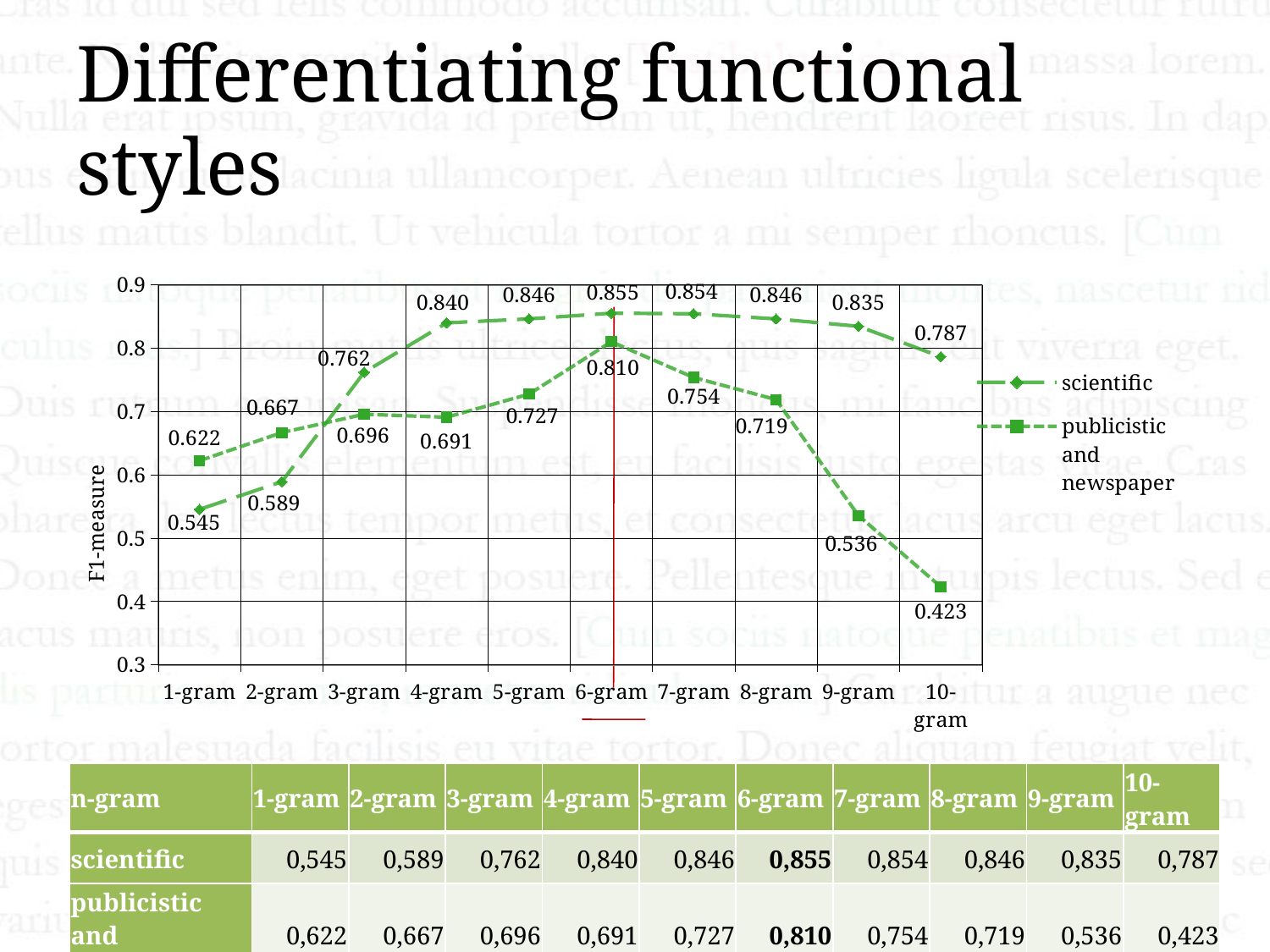
Is the F1-measure for the publicistic and newspaper series at 9-gram greater or less than 0.6? less Does the publicistic and newspaper series rise or fall from 6-gram to 10-gram? fall How many series does the chart legend list? 2 What is the F1-measure for the publicistic and newspaper series at 1-gram? 0.622 At which n-gram does the scientific series have its lowest F1-measure? 1-gram What is the difference between the scientific and the publicistic and newspaper F1-measure at 10-gram? 0.364 What type of chart is shown on the slide? line chart What is the F1-measure for the scientific series at 6-gram? 0.855 What is the label of the y axis of the chart? F1-measure At which n-gram does the publicistic and newspaper series reach its highest F1-measure? 6-gram Which series has the higher F1-measure at 2-gram? publicistic and newspaper How many n-gram categories are plotted along the x axis? 10